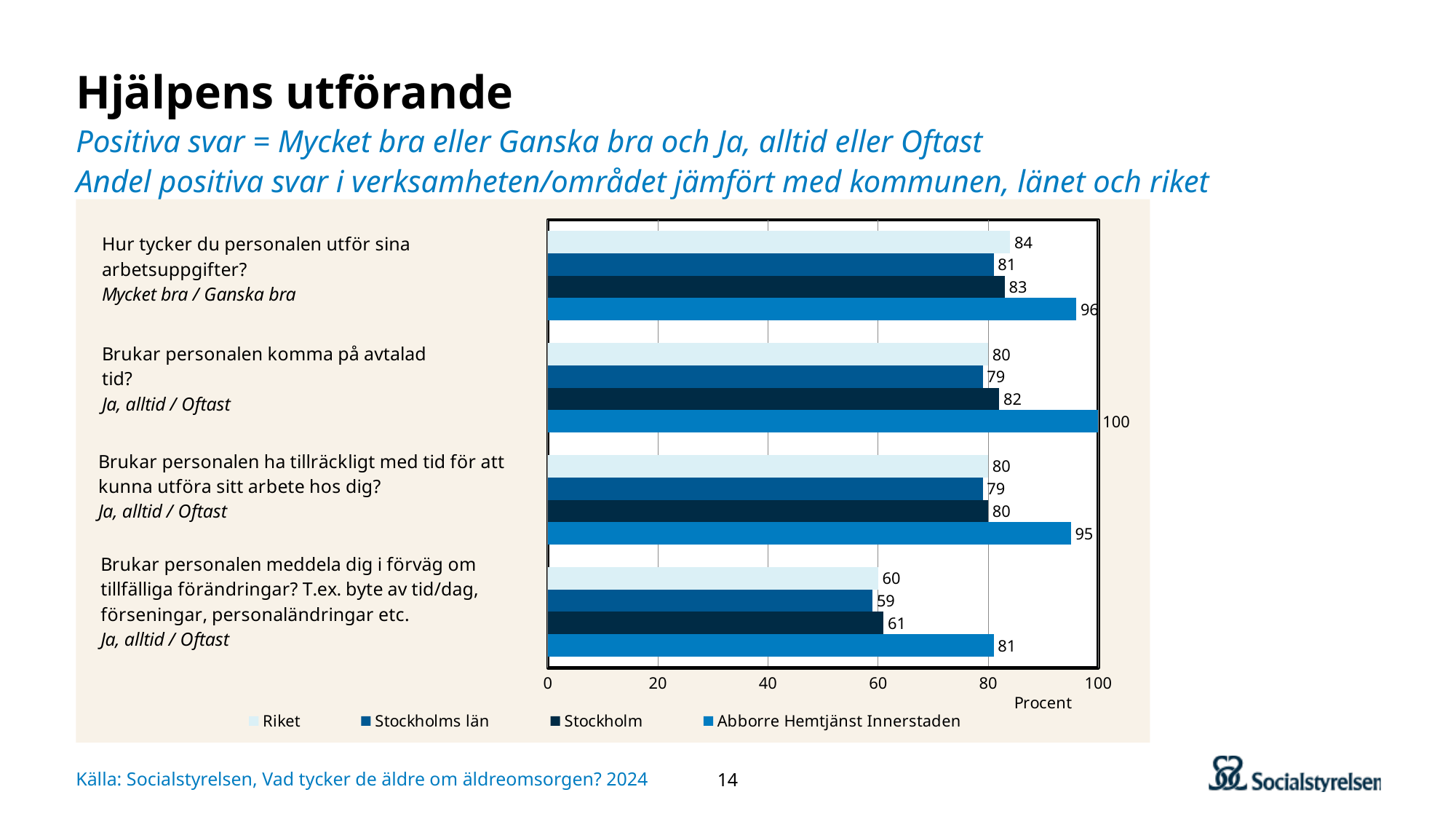
What is the value for Abborre Hemtjänst Innerstaden on "Brukar personalen komma på avtalad tid?"? 100 What is the difference between Abborre Hemtjänst Innerstaden and Riket on "Hur tycker du personalen utför sina arbetsuppgifter?"? 12 What is the value for Riket on "Hur tycker du personalen utför sina arbetsuppgifter?"? 84 Which is larger on "Brukar personalen meddela dig i förväg om tillfälliga förändringar?": Stockholm or Abborre Hemtjänst Innerstaden? Abborre Hemtjänst Innerstaden Which series has the lowest value on "Brukar personalen meddela dig i förväg om tillfälliga förändringar?"? Stockholms län What kind of chart is shown on the slide? Bar chart How many series does the legend list? 4 Which series has the highest value on "Brukar personalen ha tillräckligt med tid för att kunna utföra sitt arbete hos dig?"? Abborre Hemtjänst Innerstaden What unit label is shown on the x axis of the chart? Procent Is the value for Riket on "Brukar personalen meddela dig i förväg om tillfälliga förändringar?" greater or less than 80? less What is the value for Stockholms län on "Brukar personalen meddela dig i förväg om tillfälliga förändringar?"? 59 How many survey questions (categories) are plotted in the chart? 4